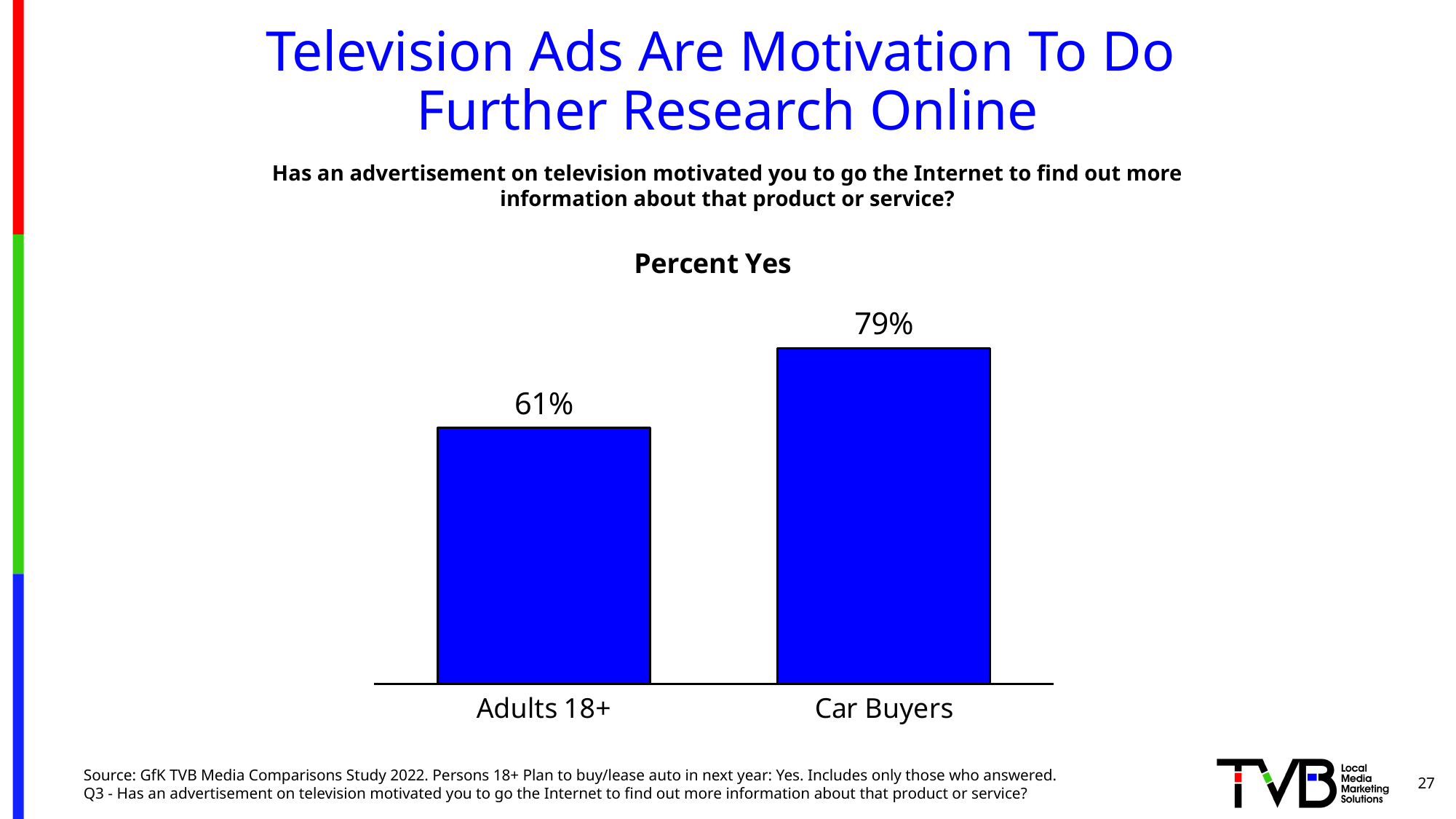
What is the title of the chart? Percent Yes How many categories are shown in the chart? 2 Which is larger, the Percent Yes for Adults 18+ or for Car Buyers? Car Buyers Which category has the highest Percent Yes value? Car Buyers What colour are the bars in the chart? Blue What is the Percent Yes value for Adults 18+? 61% What is the difference in Percent Yes between Car Buyers and Adults 18+? 18% What is the Percent Yes value for Car Buyers? 79% What kind of chart is shown on the slide? Bar chart Which category has the lowest Percent Yes value? Adults 18+